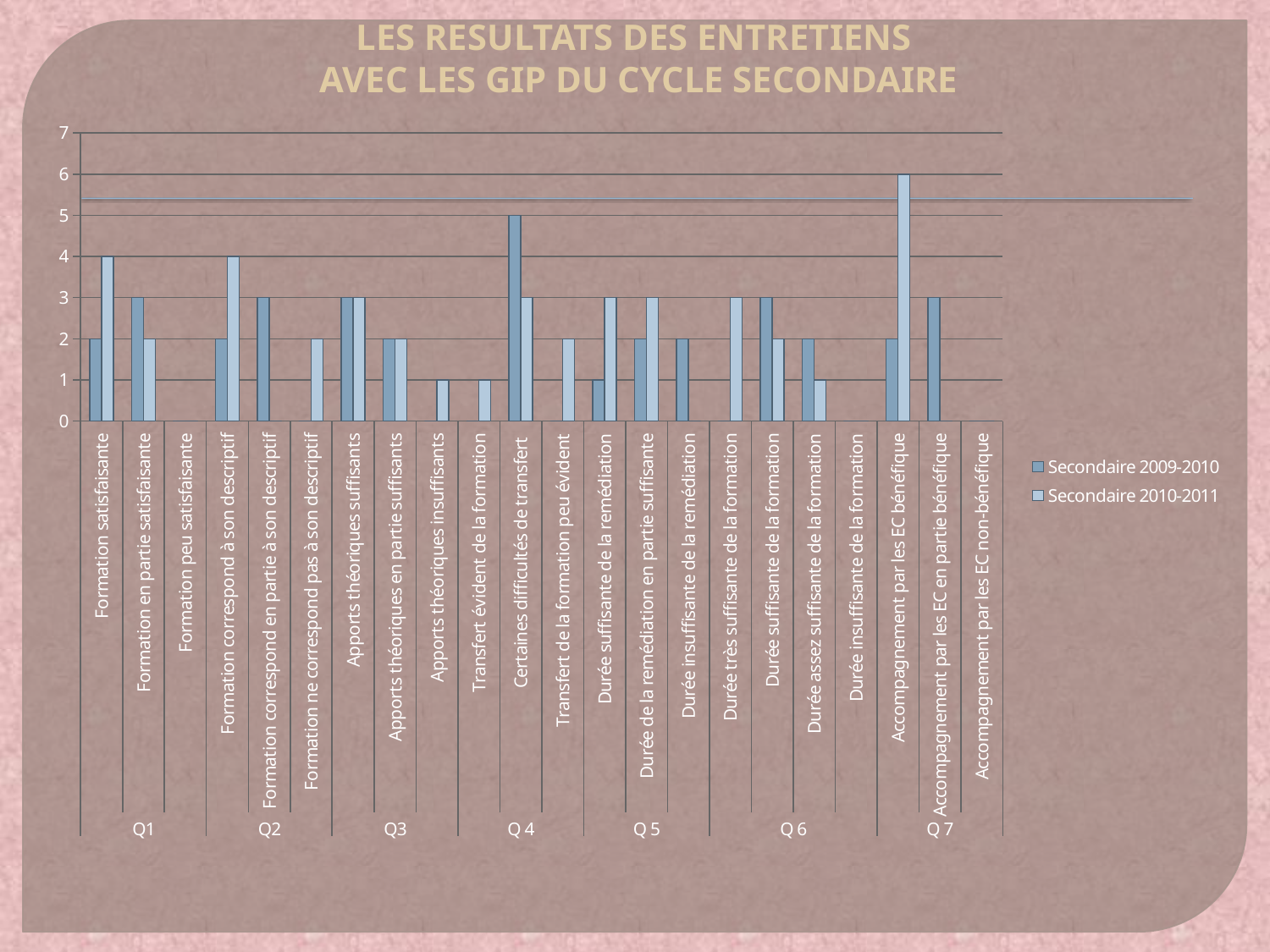
How many series does the legend list? 2 What is the title of the chart? LES RESULTATS DES ENTRETIENS AVEC LES GIP DU CYCLE SECONDAIRE What is the value for "Accompagnement par les EC bénéfique" in the Secondaire 2010-2011 series? 6 What is the value for "Certaines difficultés de transfert" in the Secondaire 2009-2010 series? 5 What is the value for "Durée suffisante de la remédiation" in the Secondaire 2009-2010 series? 1 Which category has the highest value in the Secondaire 2009-2010 series? Certaines difficultés de transfert What type of chart is shown on the slide? bar chart What is the difference between the Secondaire 2010-2011 and Secondaire 2009-2010 values for "Accompagnement par les EC bénéfique"? 4 What is the value for "Formation satisfaisante" in the Secondaire 2010-2011 series? 4 For "Formation en partie satisfaisante", which series has the larger value, Secondaire 2009-2010 or Secondaire 2010-2011? Secondaire 2009-2010 Which category has the highest value in the Secondaire 2010-2011 series? Accompagnement par les EC bénéfique What is the value for "Apports théoriques suffisants" in the Secondaire 2010-2011 series? 3